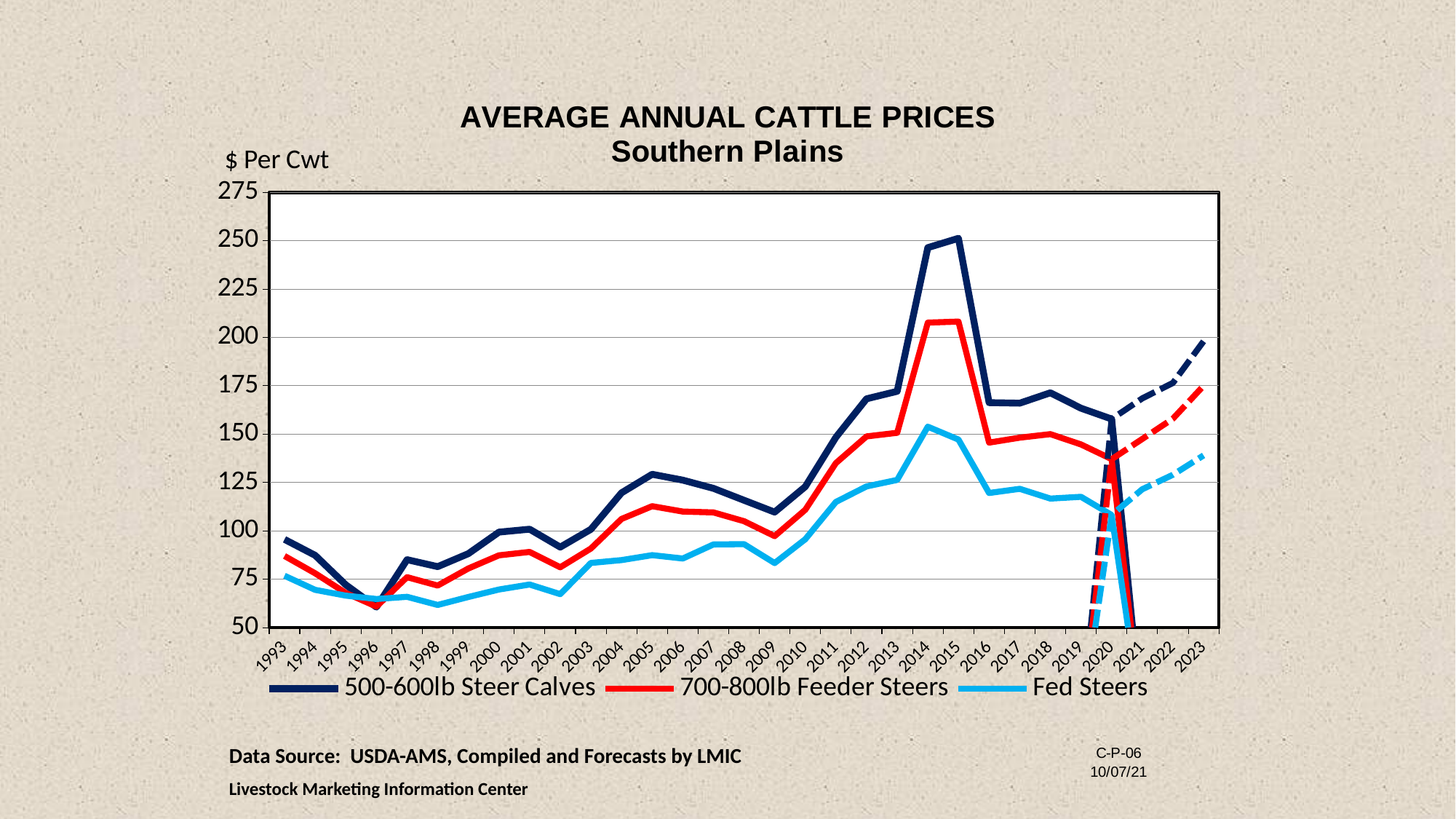
In which year does the 500-600lb Steer Calves series reach its highest value? 2015 What unit label is shown above the y axis? $ Per Cwt Did the 500-600lb Steer Calves series rise or fall from 2015 to 2016? fall In which year is the 700-800lb Feeder Steers series at its lowest? 1996 How many years are plotted along the x axis? 31 In 2010, which series has the higher value, 500-600lb Steer Calves or Fed Steers? 500-600lb Steer Calves Is the value for Fed Steers in 1996 greater or less than 75? less Is the value for 500-600lb Steer Calves in 2015 greater or less than 225? greater How many series does the legend list? 3 In which year does the Fed Steers series reach its highest value? 2014 What kind of chart is shown on the slide? line chart Is the value for 700-800lb Feeder Steers in 2014 greater or less than 200? greater